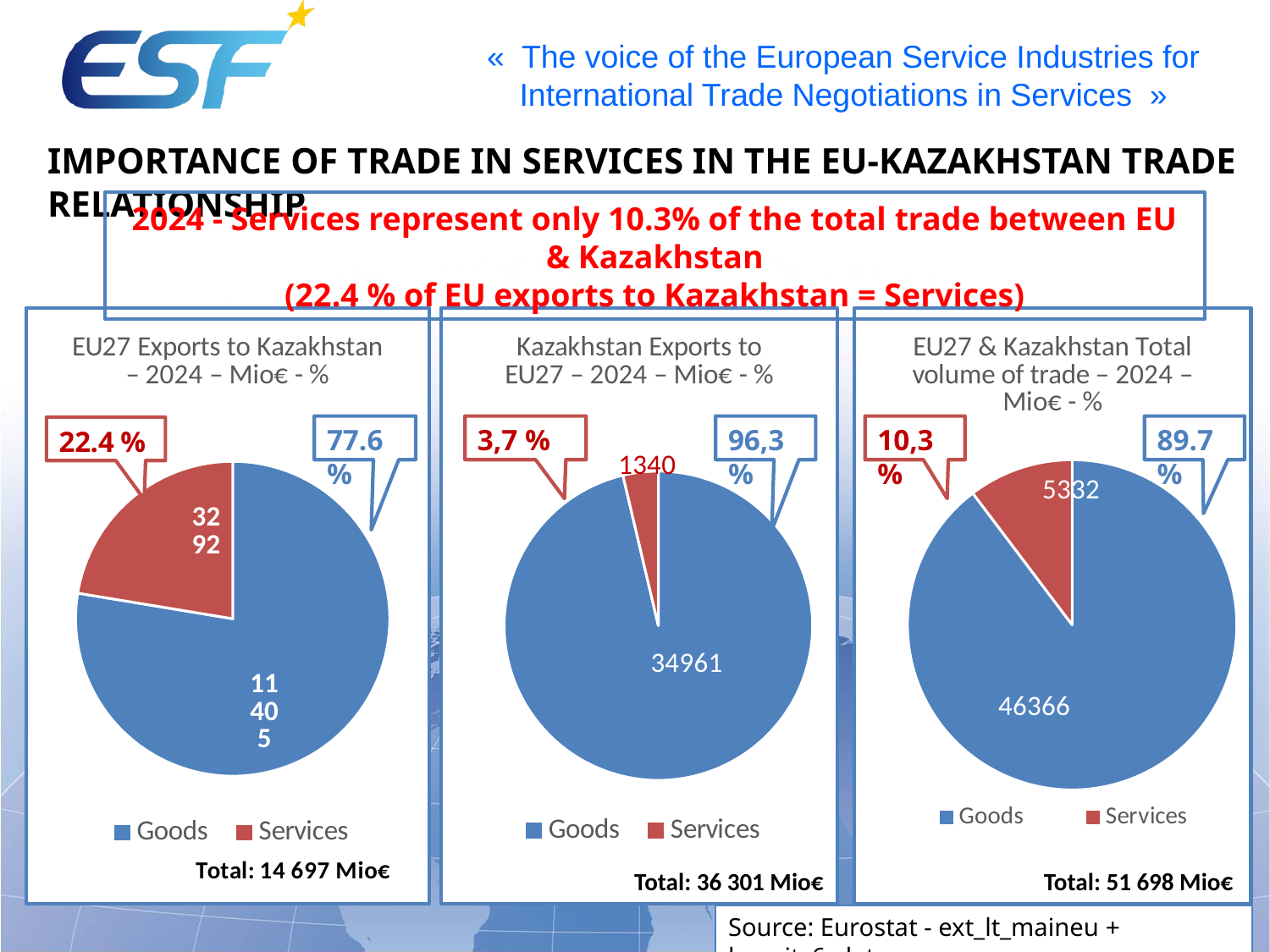
In the 'Kazakhstan Exports to EU27 – 2024' chart, what is the value for Services? 1340 In the 'EU27 & Kazakhstan Total volume of trade – 2024' chart, what is the value for Goods? 46366 In the 'Kazakhstan Exports to EU27 – 2024' chart, what is the value for Goods? 34961 In the 'EU27 & Kazakhstan Total volume of trade – 2024' chart, what is the value for Services? 5332 In the 'EU27 & Kazakhstan Total volume of trade – 2024' chart, what share of the pie is Services? 10,3 % What type of chart is used on this slide? Pie chart In the 'Kazakhstan Exports to EU27 – 2024' chart, what is the difference between the Goods and Services values? 33621 In the 'Kazakhstan Exports to EU27 – 2024' chart, what share of the pie is Goods? 96,3 % How many categories does the legend of the 'EU27 Exports to Kazakhstan – 2024' chart list? 2 What total is printed below the 'EU27 & Kazakhstan Total volume of trade – 2024' chart? Total: 51 698 Mio€ In the 'Kazakhstan Exports to EU27 – 2024' chart, which slice is larger, Goods or Services? Goods In the 'EU27 Exports to Kazakhstan – 2024' chart, what share of the pie is Services? 22.4 %